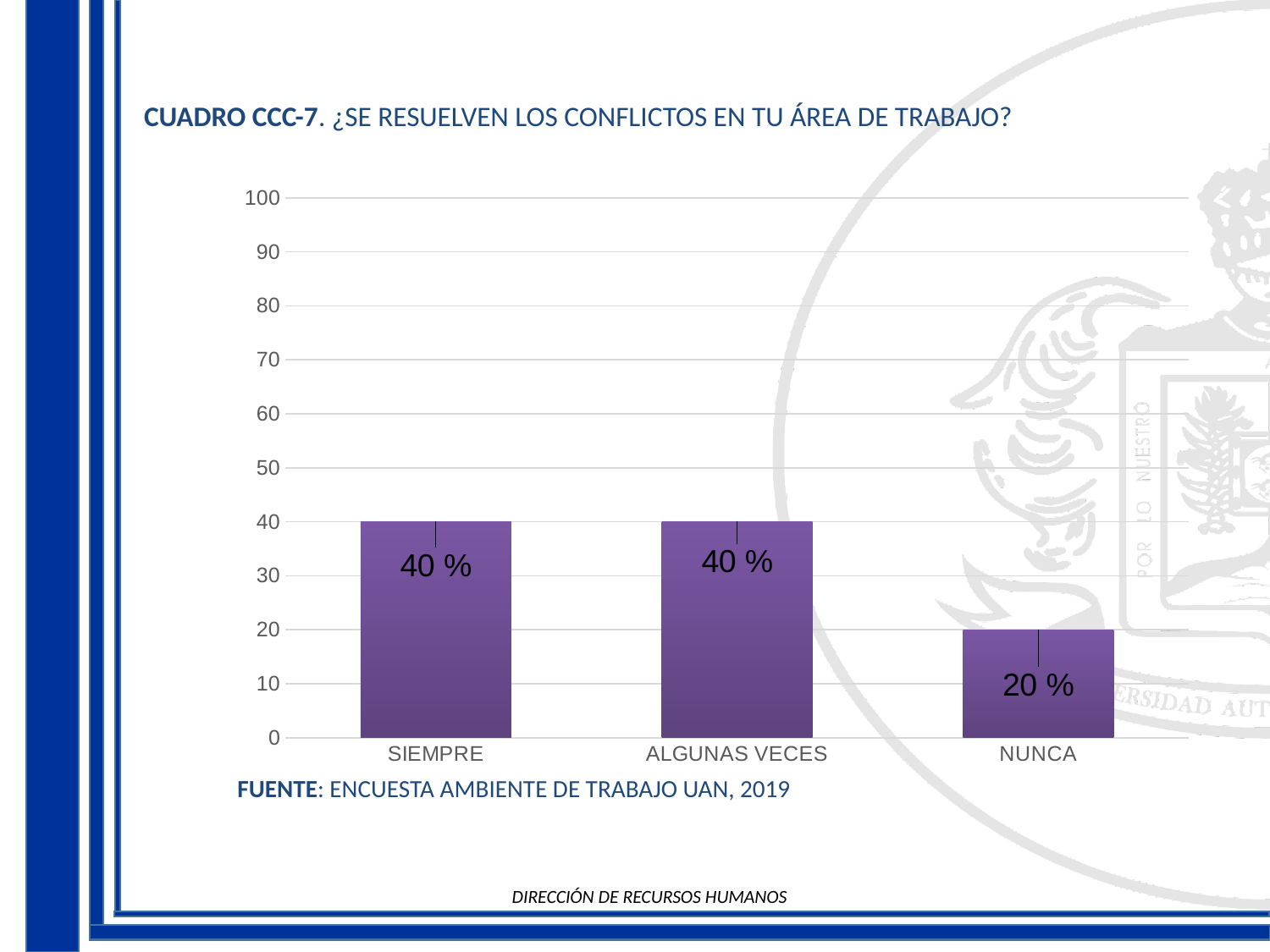
Is the value for SIEMPRE greater or less than 30? greater What is the value for NUNCA? 20 % Is the value for NUNCA greater or less than 30? less What is the highest value shown on the vertical axis? 100 Which category has the lowest value? NUNCA How many categories are shown on the x axis? 3 Which is larger, the value for ALGUNAS VECES or the value for NUNCA? ALGUNAS VECES What is the difference between the values for SIEMPRE and NUNCA? 20 % What kind of chart is shown on the slide? bar chart What source is cited below the chart? ENCUESTA AMBIENTE DE TRABAJO UAN, 2019 What is the value for SIEMPRE? 40 % What is the value for ALGUNAS VECES? 40 %